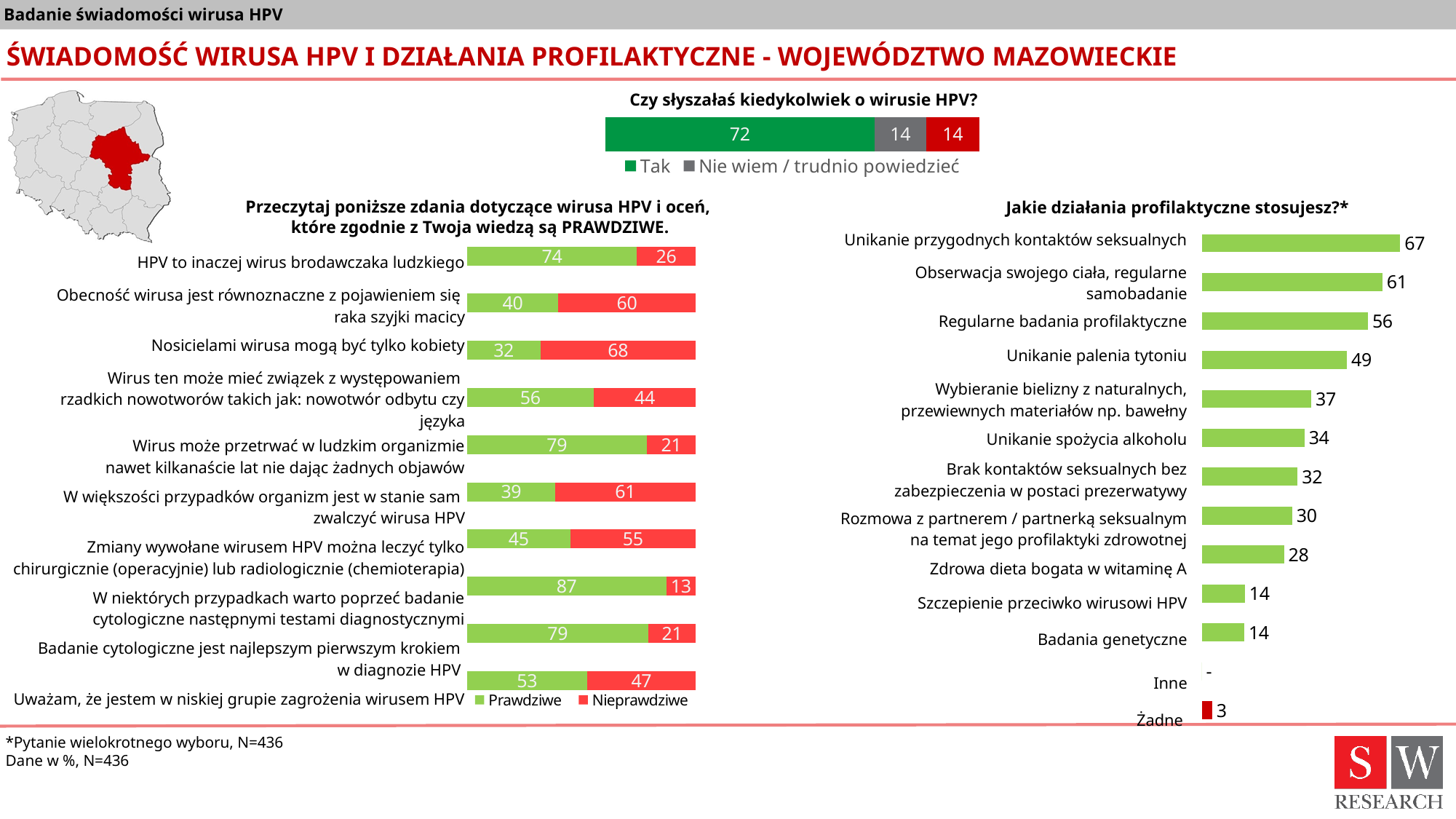
In the chart 'Jakie działania profilaktyczne stosujesz?', what is the value for 'Unikanie palenia tytoniu'? 49 In the chart 'Jakie działania profilaktyczne stosujesz?', which category has the highest value? Unikanie przygodnych kontaktów seksualnych In the chart 'Jakie działania profilaktyczne stosujesz?', what is the difference between 'Unikanie przygodnych kontaktów seksualnych' and 'Regularne badania profilaktyczne'? 11 In the chart 'Czy słyszałaś kiedykolwiek o wirusie HPV?', what is the value for 'Nie wiem / trudnio powiedzieć'? 14 How many series does the legend of the chart 'Przeczytaj poniższe zdania dotyczące wirusa HPV...' list? 2 In the chart 'Czy słyszałaś kiedykolwiek o wirusie HPV?', what is the value for 'Tak'? 72 In the chart 'Jakie działania profilaktyczne stosujesz?', what is the value for 'Żadne'? 3 In the chart 'Jakie działania profilaktyczne stosujesz?', which is larger: 'Unikanie spożycia alkoholu' or 'Rozmowa z partnerem / partnerką seksualnym na temat jego profilaktyki zdrowotnej'? Unikanie spożycia alkoholu In the chart 'Przeczytaj poniższe zdania dotyczące wirusa HPV...', what is the 'Prawdziwe' value for 'HPV to inaczej wirus brodawczaka ludzkiego'? 74 In the chart 'Przeczytaj poniższe zdania dotyczące wirusa HPV...', what is the 'Nieprawdziwe' value for 'Nosicielami wirusa mogą być tylko kobiety'? 68 What kind of chart is 'Jakie działania profilaktyczne stosujesz?'? bar chart In the chart 'Przeczytaj poniższe zdania dotyczące wirusa HPV...', what is the highest 'Prawdziwe' value shown? 87